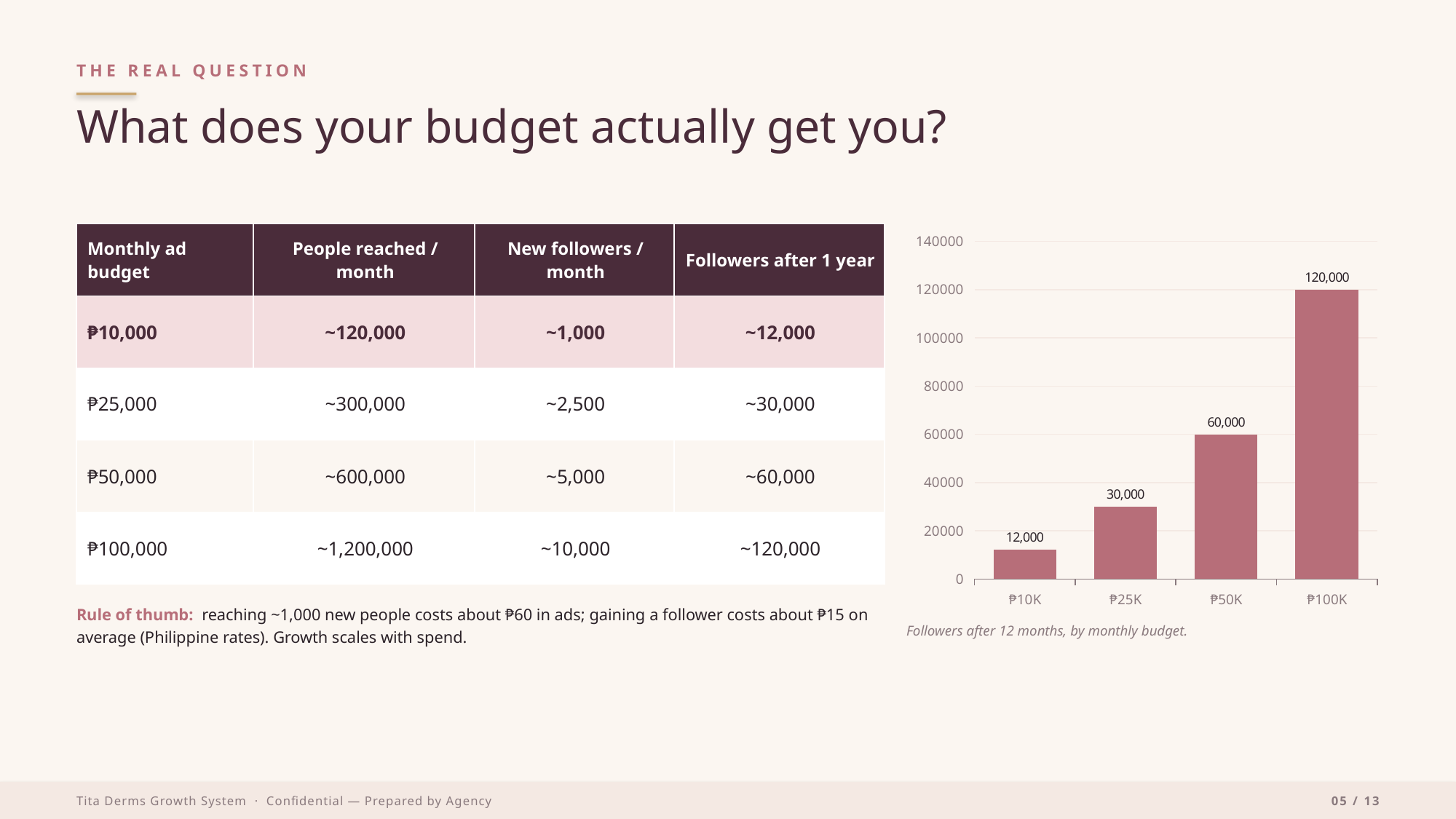
What is the value of the bar for ₱25K? 30,000 Which monthly budget has the lowest bar? ₱10K What is the difference between the bars for ₱100K and ₱50K? 60,000 Is the value for ₱50K greater or less than 40000? greater Do the bar values rise or fall from ₱10K to ₱100K? Rise What is the value of the bar for ₱100K? 120,000 What kind of chart is shown on the slide? Bar chart What is the difference between the bars for ₱25K and ₱10K? 18,000 How many bars are shown in the chart? 4 Which monthly budget has the highest bar? ₱100K What is the value of the bar for ₱10K? 12,000 Which is larger, the bar for ₱50K or the bar for ₱25K? ₱50K